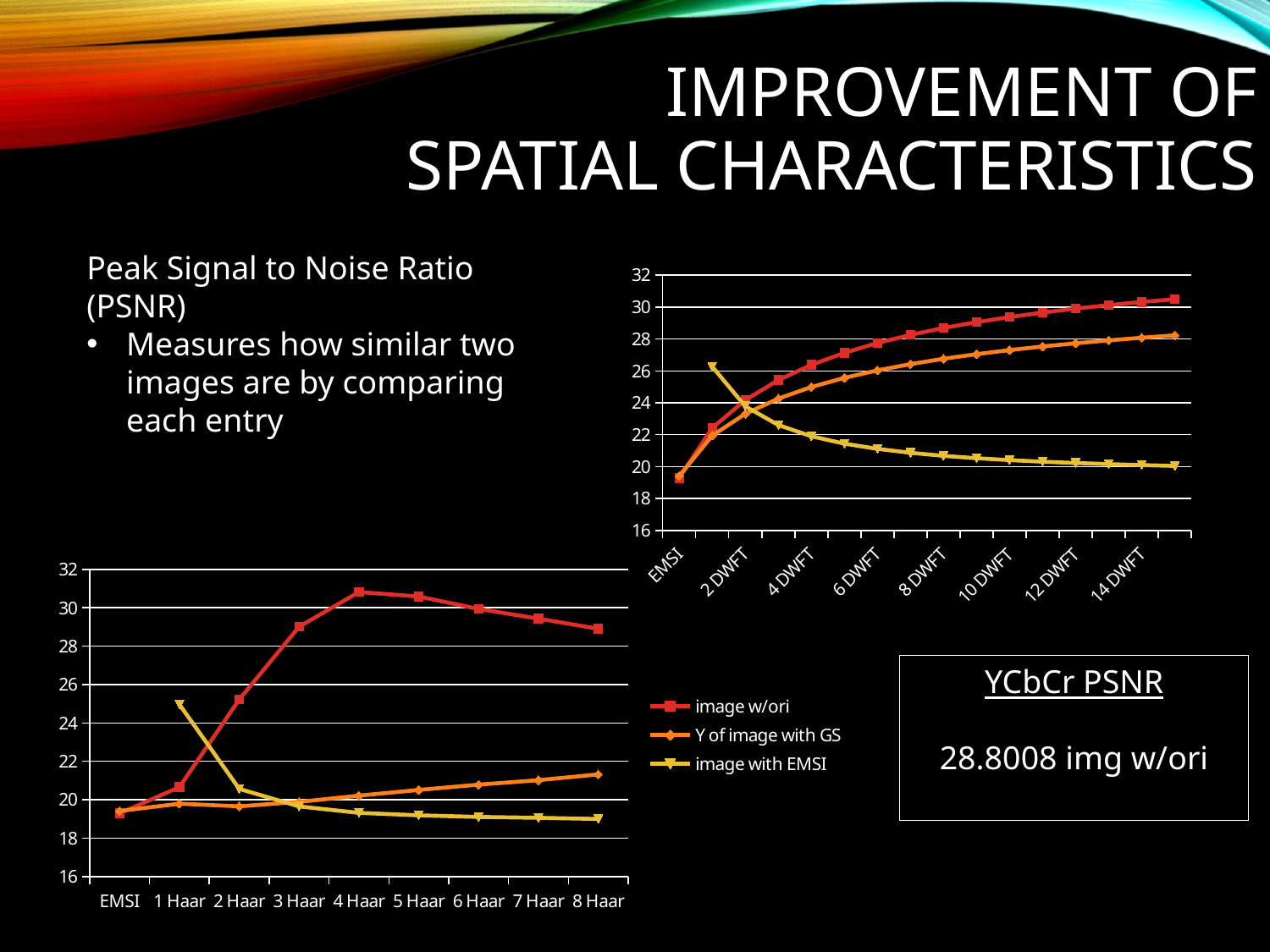
In the top-right chart, does the image w/ori series rise or fall from EMSI to 14 DWFT? rise How many series does the legend list? 3 In the bottom-left chart, is the value of image w/ori at 4 Haar greater or less than 30? greater In the bottom-left chart, at 8 Haar, which is larger: image w/ori or Y of image with GS? image w/ori In the top-right chart, does the image with EMSI series rise or fall from 2 DWFT to 14 DWFT? fall In the bottom-left chart, is the value of image with EMSI at 1 Haar greater or less than 24? greater Which legend entry is shown with a yellow line? image with EMSI In the top-right chart, at 4 DWFT, which is larger: image w/ori or image with EMSI? image w/ori What kind of chart is the bottom-left chart with the Haar categories? line chart In the bottom-left chart, how many categories are on the x axis? 9 In the bottom-left chart, at which category does the image w/ori series reach its highest value? 4 Haar